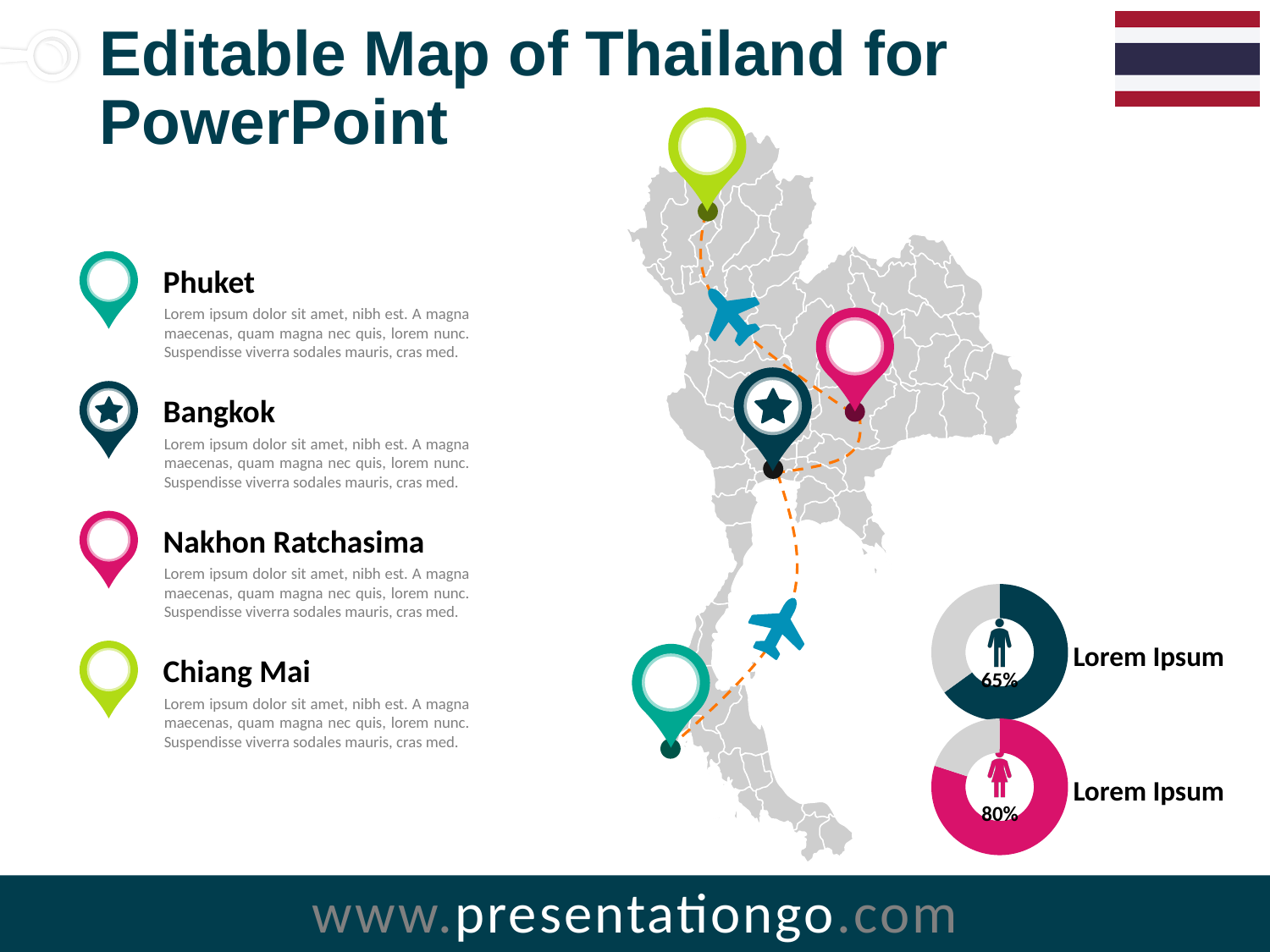
Which of the two donut charts shows the larger percentage, the top one (male icon) or the bottom one (female icon)? the bottom one (female icon), 80% What label text appears to the right of each donut chart? Lorem Ipsum How many donut charts are on the slide? 2 What is the difference between the percentages shown in the bottom donut chart (80%) and the top donut chart (65%)? 15 percentage points What kind of charts are shown at the bottom right of the slide? donut (pie) charts What percentage is shown in the bottom donut chart (with the female figure icon)? 80% Which donut chart shows the smaller percentage? the top one (male icon), 65% What share of the top donut chart (male icon) is filled with the dark colour? 65% What share of the bottom donut chart (female icon) is filled with the pink colour? 80% What colour is the filled portion of the bottom donut chart (female icon)? pink What percentage is shown in the top donut chart (with the male figure icon)? 65%